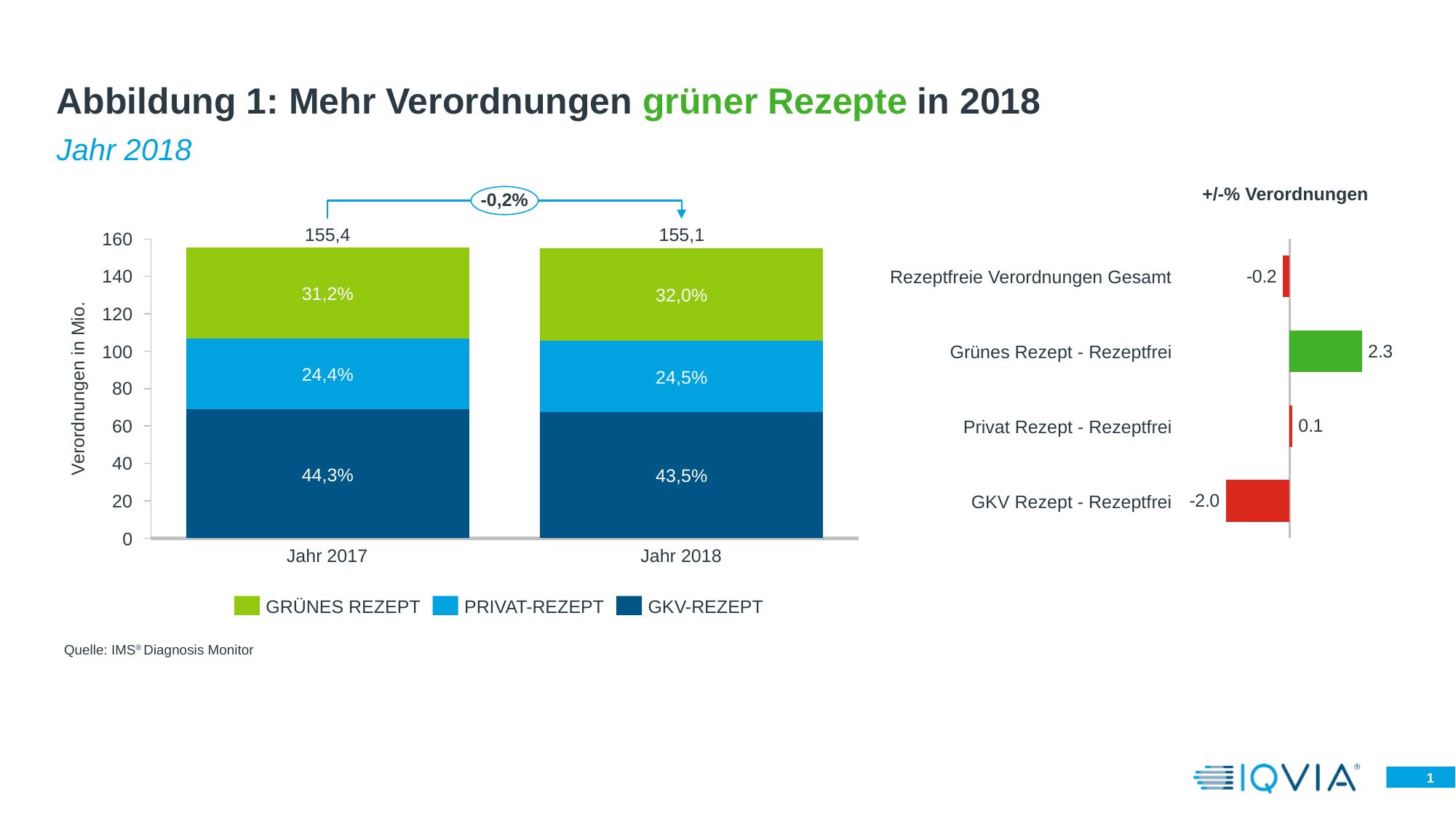
In the left stacked bar chart, what percentage share does PRIVAT-REZEPT have in Jahr 2018? 24,5% In the left stacked bar chart, what percentage share does GRÜNES REZEPT have in Jahr 2018? 32,0% In the right chart titled '+/-% Verordnungen', what is the value for GKV Rezept - Rezeptfrei? -2.0 In the left stacked bar chart, how many series does the legend list? 3 In the left stacked bar chart, which series has the largest share in Jahr 2017? GKV-REZEPT In the right chart titled '+/-% Verordnungen', how many categories are shown? 4 In the left stacked bar chart, what is the total value shown above the bar for Jahr 2017? 155,4 In the right chart titled '+/-% Verordnungen', what is the value for Grünes Rezept - Rezeptfrei? 2.3 In the left stacked bar chart, what is the total value shown above the bar for Jahr 2018? 155,1 In the left stacked bar chart, what percentage share does GKV-REZEPT have in Jahr 2017? 44,3% In the left stacked bar chart, what percentage change between Jahr 2017 and Jahr 2018 is shown in the oval above the bars? -0,2% In the right chart titled '+/-% Verordnungen', which category has the lowest value? GKV Rezept - Rezeptfrei